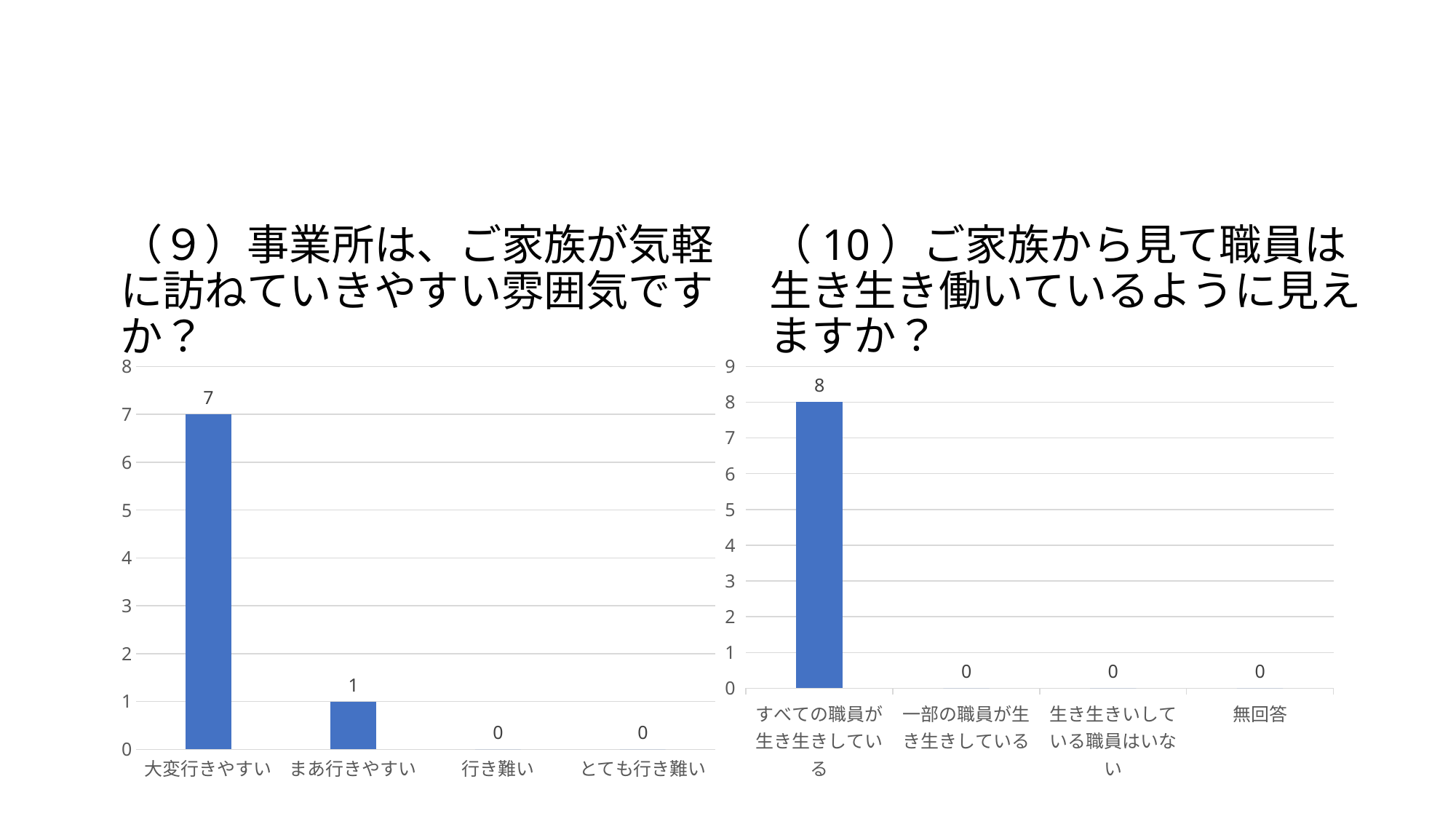
In the left chart (question 9), how many categories are shown on the x axis? 4 In the right chart (question 10), which category has the highest value? すべての職員が生き生きしている In the left chart (question 9), what is the value for まあ行きやすい? 1 In the left chart (question 9), which category has the highest value? 大変行きやすい In the left chart (question 9), what is the difference between 大変行きやすい and まあ行きやすい? 6 In the right chart (question 10), what is the value for 無回答? 0 In the right chart (question 10), how many categories are shown on the x axis? 4 Which is larger: the value for 大変行きやすい in the left chart or the value for すべての職員が生き生きしている in the right chart? すべての職員が生き生きしている In the left chart (question 9), what is the value for 大変行きやすい? 7 In the left chart (question 9), what is the value for 行き難い? 0 What kind of chart is the right chart (question 10)? Bar chart In the right chart (question 10), what is the value for すべての職員が生き生きしている? 8